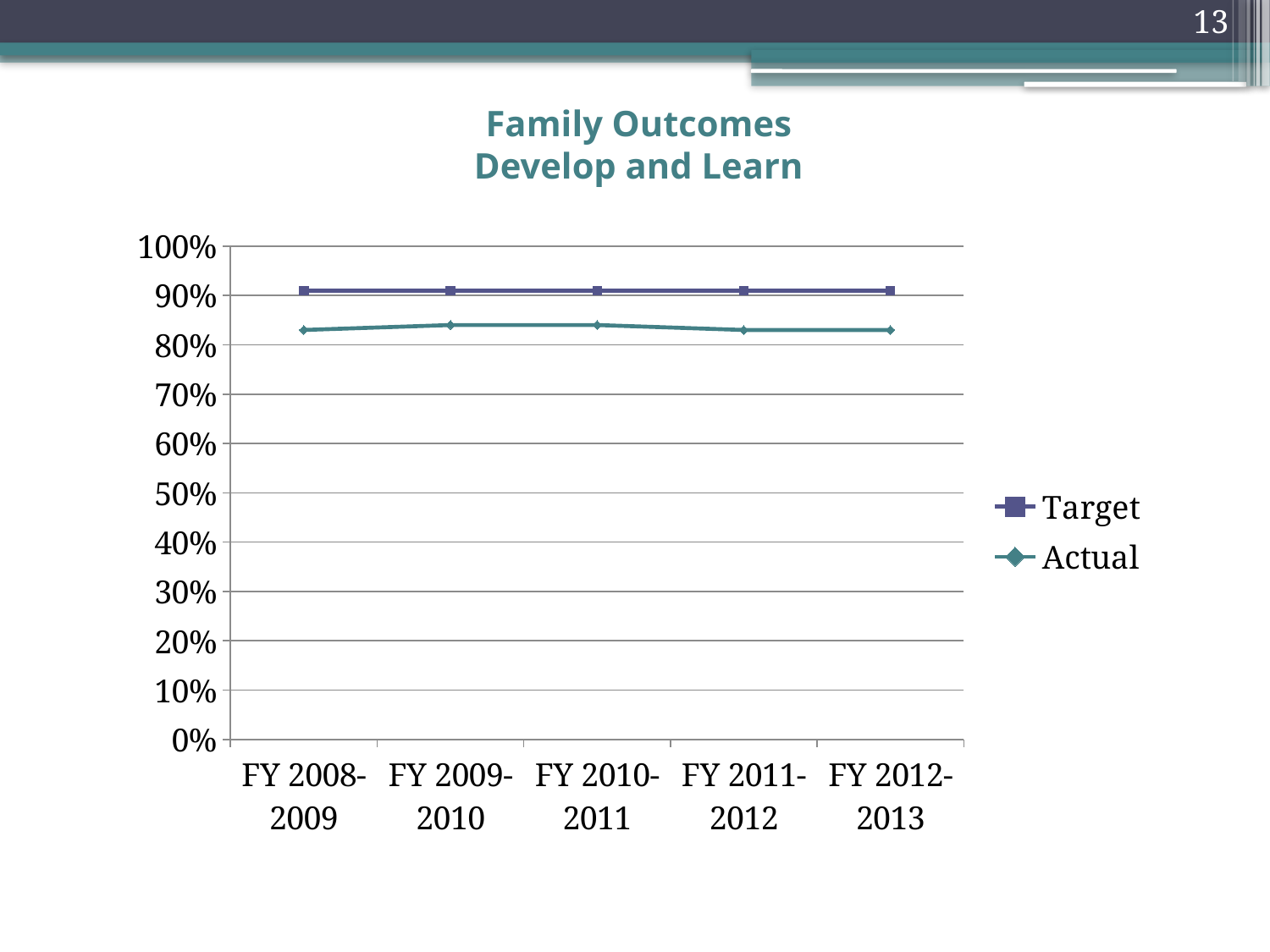
Which series is higher in FY 2008-2009, Target or Actual? Target Is the Target value for FY 2011-2012 greater or less than 80%? greater Is the Actual value for FY 2010-2011 greater or less than 90%? less How many fiscal years are plotted along the x axis? 5 Which series is higher in FY 2012-2013, Target or Actual? Target Does the Target line rise, fall, or stay flat across the fiscal years? stays flat How many series does the legend list? 2 Which series is drawn with square markers? Target Is the Actual value for FY 2008-2009 greater or less than 80%? greater What is the title of the chart? Family Outcomes Develop and Learn What kind of chart is shown on the slide? line chart